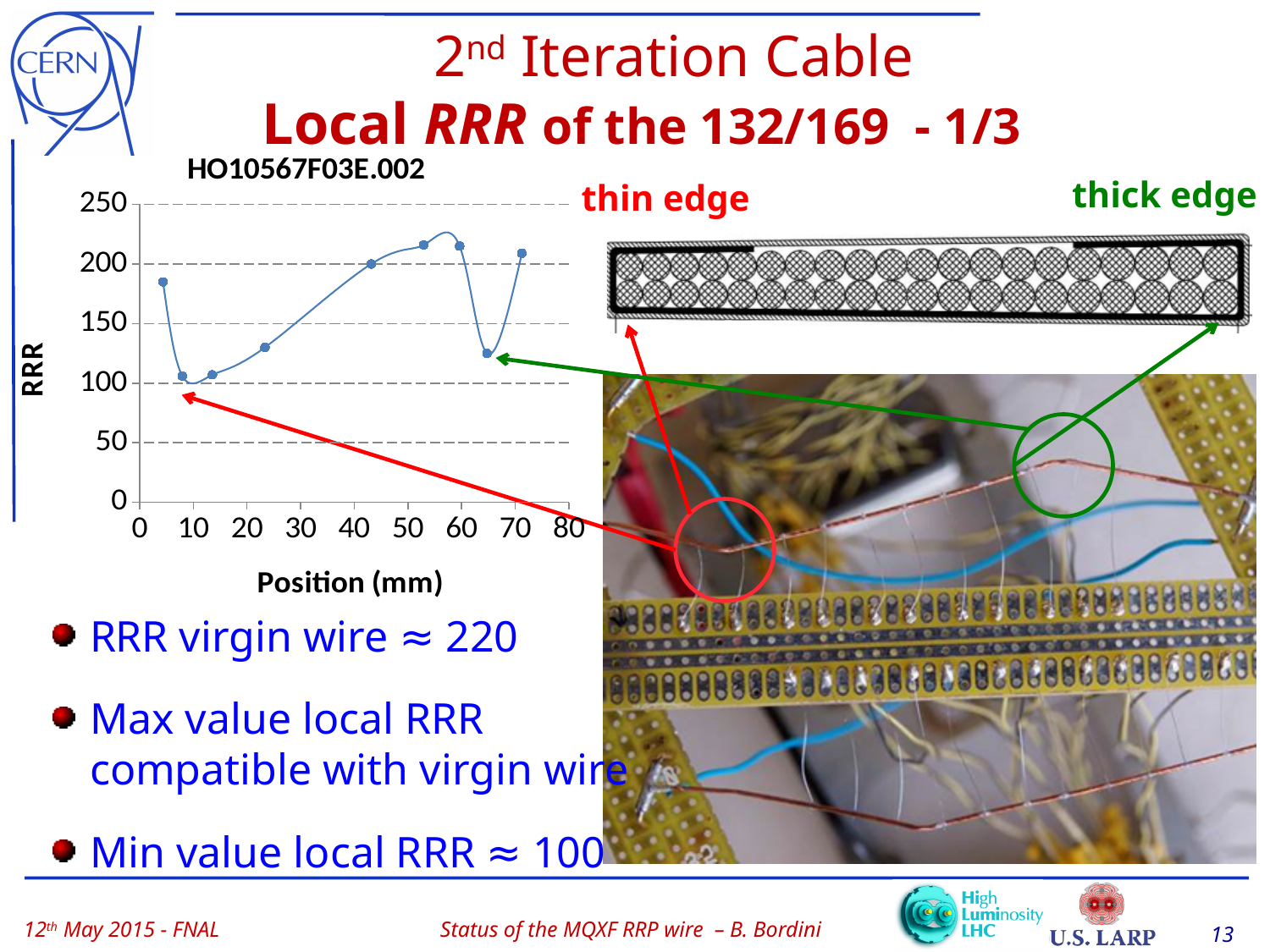
Is the RRR value at a position of about 43 mm greater or less than 150? greater Which has the larger RRR value: the point at about 43 mm or the point at about 8 mm? the point at about 43 mm Is the RRR value at a position of about 4 mm greater or less than 150? greater What kind of chart is shown on the slide? line chart What is the highest value shown on the RRR axis? 250 Is the RRR value at a position of about 8 mm greater or less than 150? less What is the title printed above the chart? HO10567F03E.002 What is the label of the x axis of the chart? Position (mm) How many data points are plotted on the chart? 9 Between positions of about 10 mm and 50 mm, do the RRR values rise or fall? rise